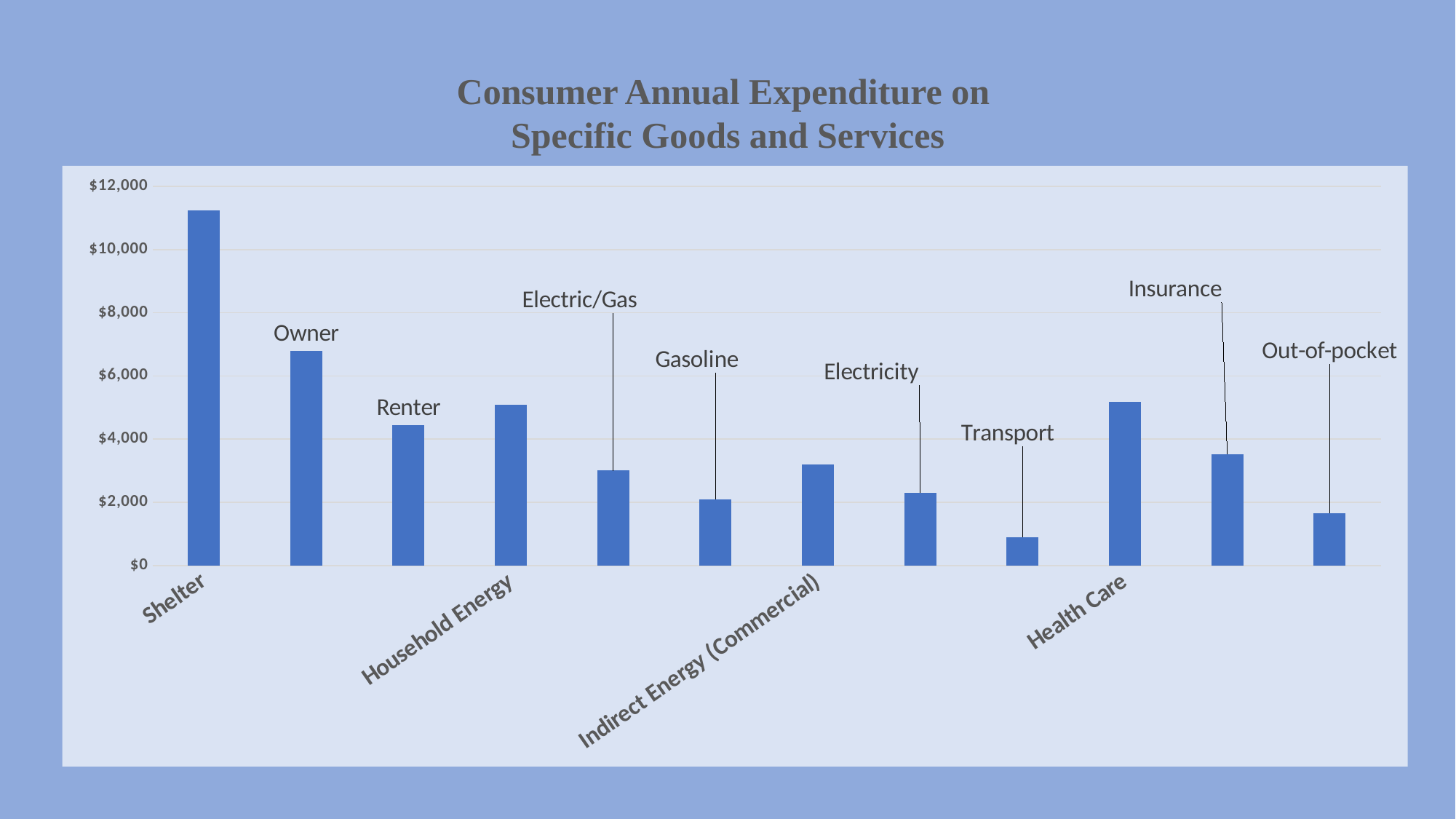
Is the value for Owner greater or less than $6,000? greater What is the title of the chart? Consumer Annual Expenditure on Specific Goods and Services Is the value for Gasoline greater or less than $4,000? less Is the value for Transport greater or less than $2,000? less How many bars (categories) are plotted in the chart? 12 Which category has the highest annual expenditure? Shelter Which category has the lowest annual expenditure? Transport Which is larger, the value for Owner or the value for Renter? Owner Which is larger, the value for Out-of-pocket or the value for Transport? Out-of-pocket What type of chart is shown on the slide? Bar chart